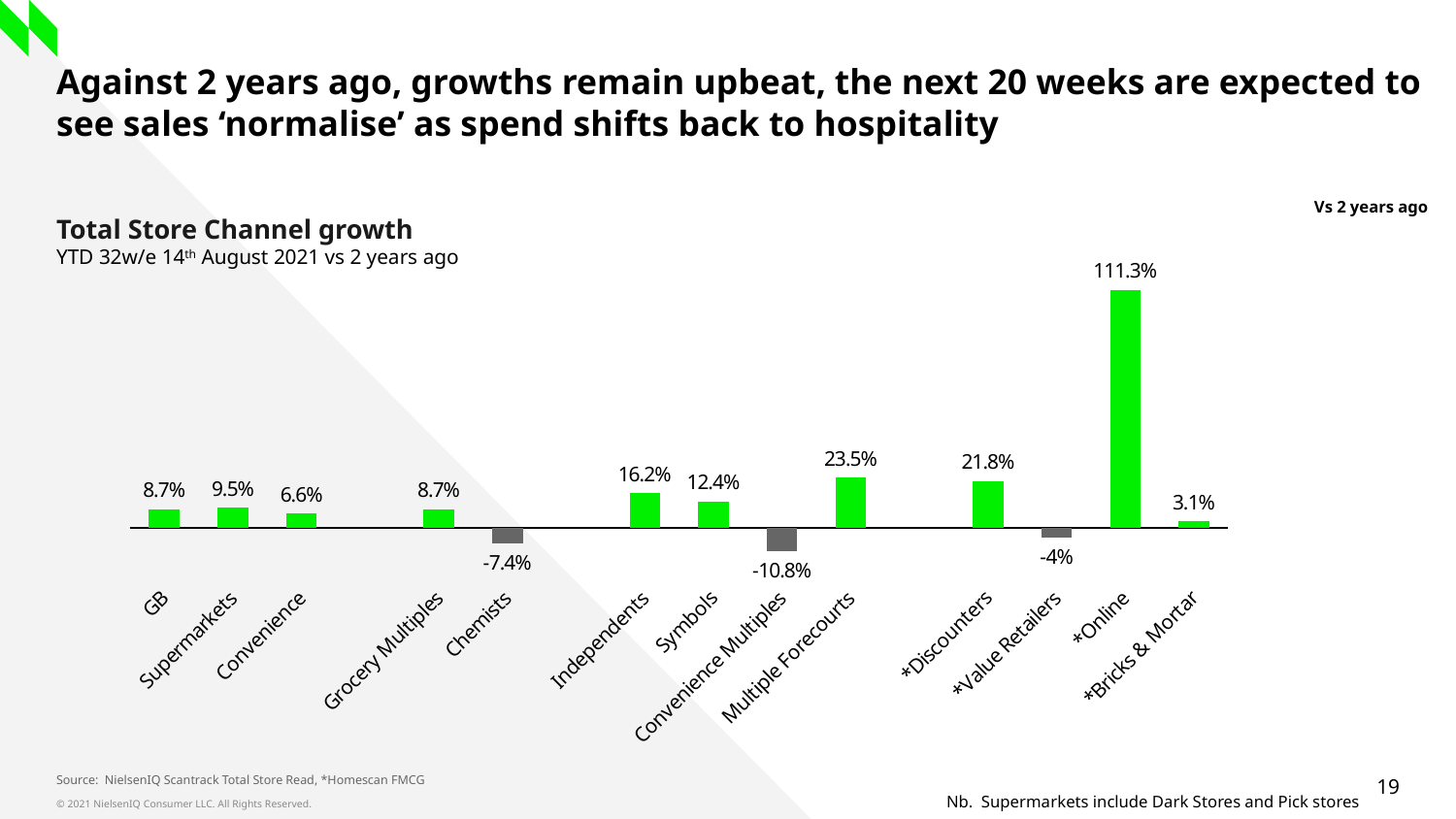
What is the growth value for Multiple Forecourts? 23.5% What is the growth value for Supermarkets? 9.5% What is the difference between the growth for Multiple Forecourts and *Discounters? 1.7% What is the title of the chart? Total Store Channel growth Which channel has the lowest growth? Convenience Multiples What kind of chart is shown on the slide? Bar chart Which channel has the highest growth? *Online What colour are the bars with negative growth values? Grey Which is larger, the growth for Independents or for Symbols? Independents What is the growth value for Chemists? -7.4% How many channels are shown in the chart? 13 What is the growth value for *Online? 111.3%